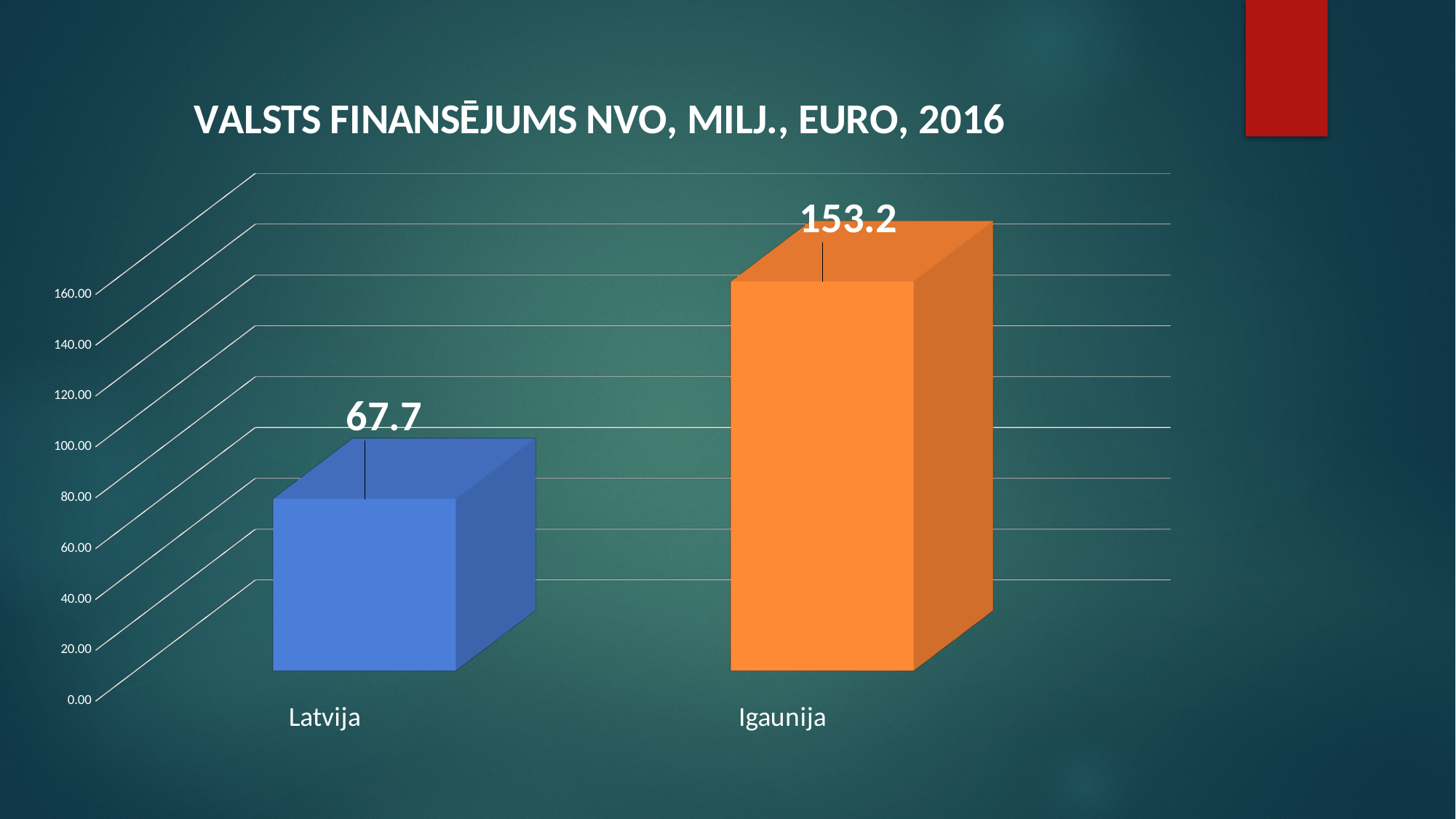
What kind of chart is shown on the slide? bar chart What is the value for Latvija? 67.7 Which is larger, the value for Latvija or the value for Igaunija? Igaunija Is the value for Igaunija greater or less than 140? greater How many categories are shown in the chart? 2 What colour is the bar for Igaunija? orange What is the difference between the values for Igaunija and Latvija? 85.5 What is the title of the chart? VALSTS FINANSĒJUMS NVO, MILJ., EURO, 2016 Which category has the highest value? Igaunija Is the value for Latvija greater or less than 80? less Which category has the lowest value? Latvija What is the value for Igaunija? 153.2